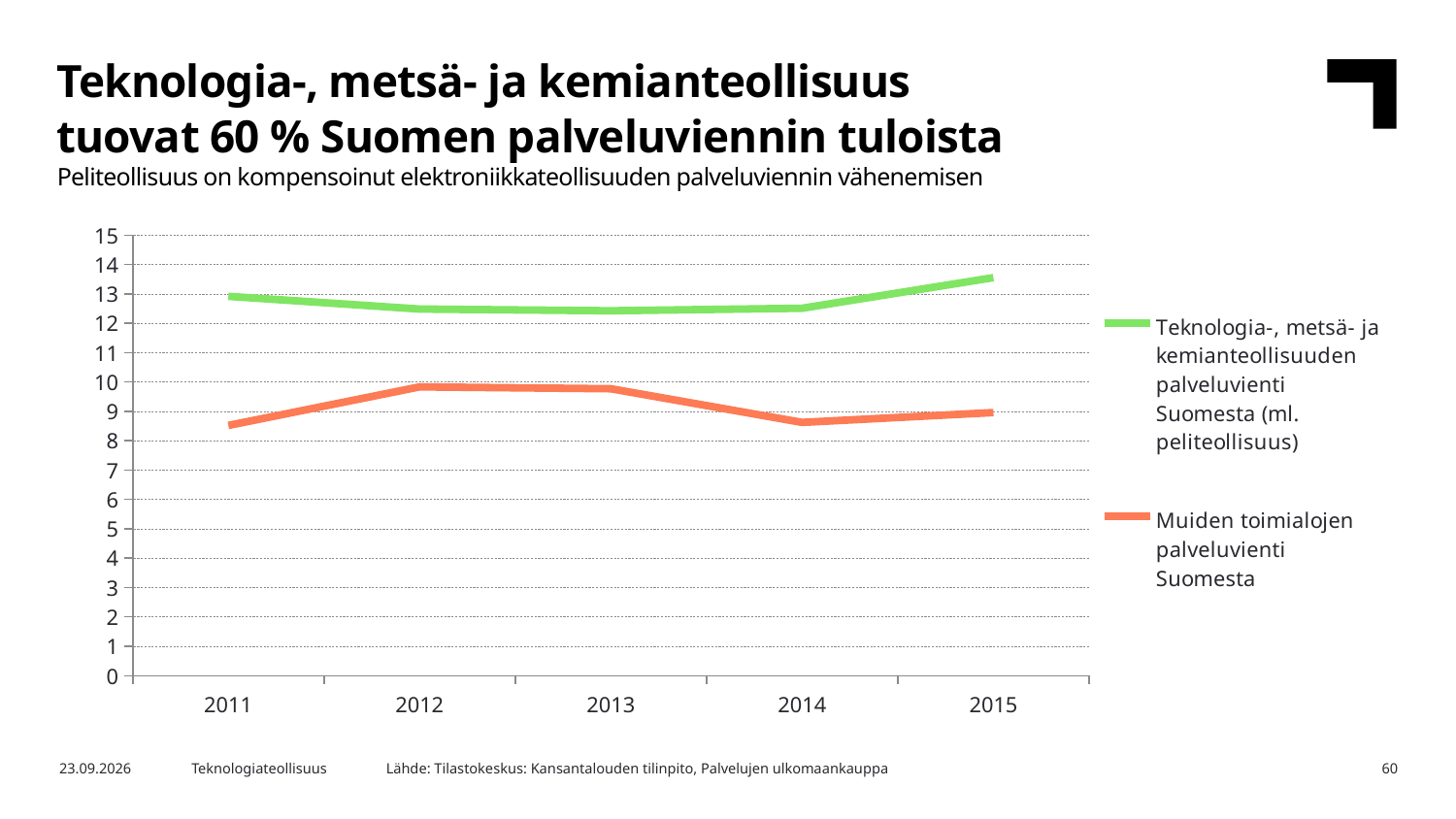
Which series has the higher value in 2014? Teknologia-, metsä- ja kemianteollisuuden palveluvienti Suomesta (ml. peliteollisuus) Is the value for Teknologia-, metsä- ja kemianteollisuuden palveluvienti Suomesta in 2013 greater or less than 12? greater Is the value for Teknologia-, metsä- ja kemianteollisuuden palveluvienti Suomesta in 2015 greater or less than 13? greater Is the value for Muiden toimialojen palveluvienti Suomesta in 2012 greater or less than 9? greater In which year is the Muiden toimialojen palveluvienti Suomesta series at its lowest? 2011 What colour is the line for Muiden toimialojen palveluvienti Suomesta? orange How many series does the legend list? 2 What kind of chart is shown on the slide? line chart How many years are shown on the x axis? 5 Does the Teknologia-, metsä- ja kemianteollisuuden palveluvienti series rise or fall between 2014 and 2015? rise In which year does the Teknologia-, metsä- ja kemianteollisuuden palveluvienti series reach its highest value? 2015